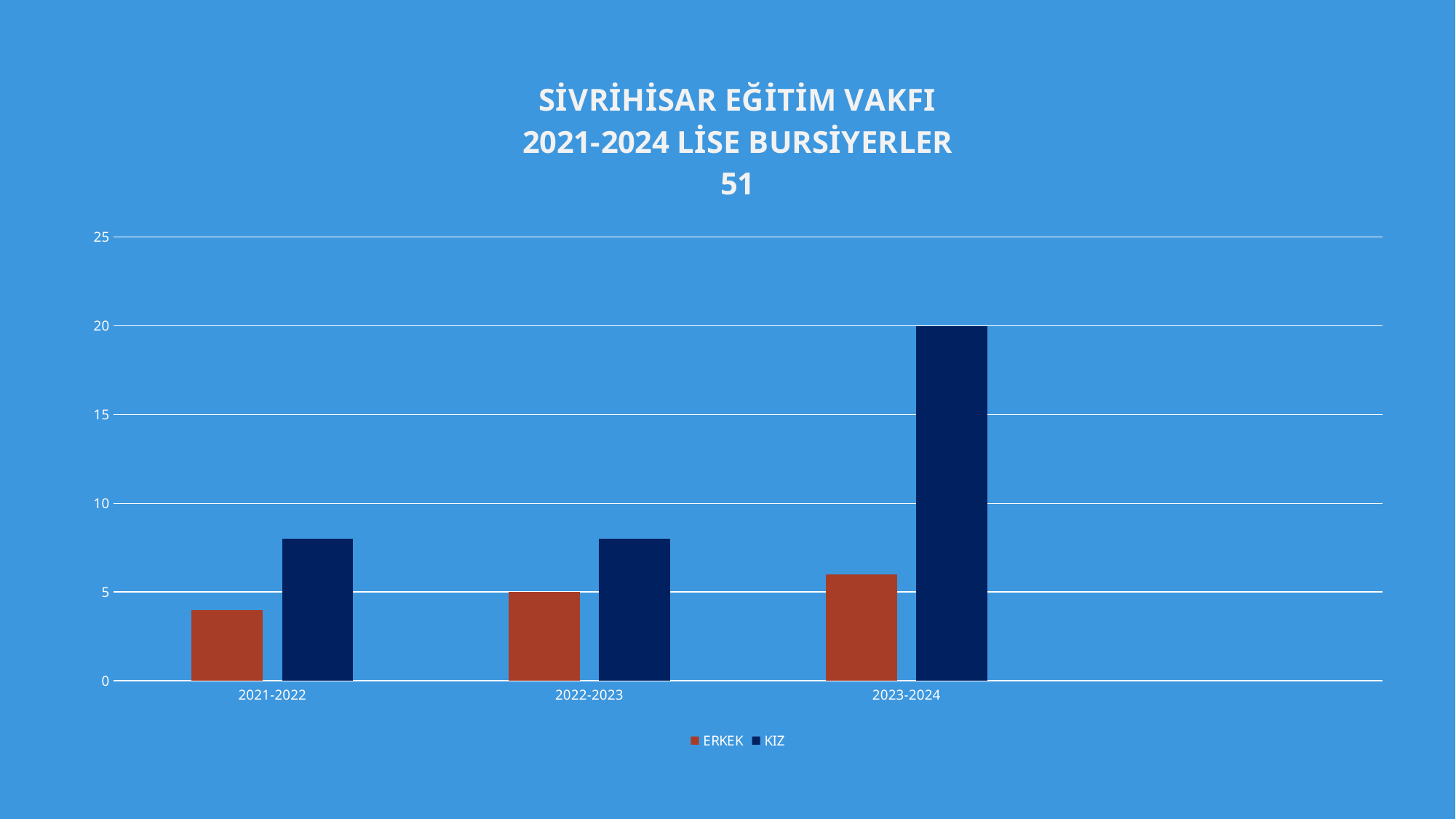
Is the value for KIZ in 2021-2022 greater or less than 10? less What is the value for KIZ in 2023-2024? 20 Is the value for ERKEK in 2021-2022 greater or less than 5? less How many series does the legend list? 2 How many academic-year categories are shown on the x axis? 3 In 2023-2024, which is larger, ERKEK or KIZ? KIZ Do the ERKEK values rise or fall from 2021-2022 to 2023-2024? rise What type of chart is shown on the slide? Bar chart Which bar is the highest in the chart? KIZ in 2023-2024 Which bar is the lowest in the chart? ERKEK in 2021-2022 What is the value for ERKEK in 2022-2023? 5 What are the two legend entries of the chart? ERKEK and KIZ